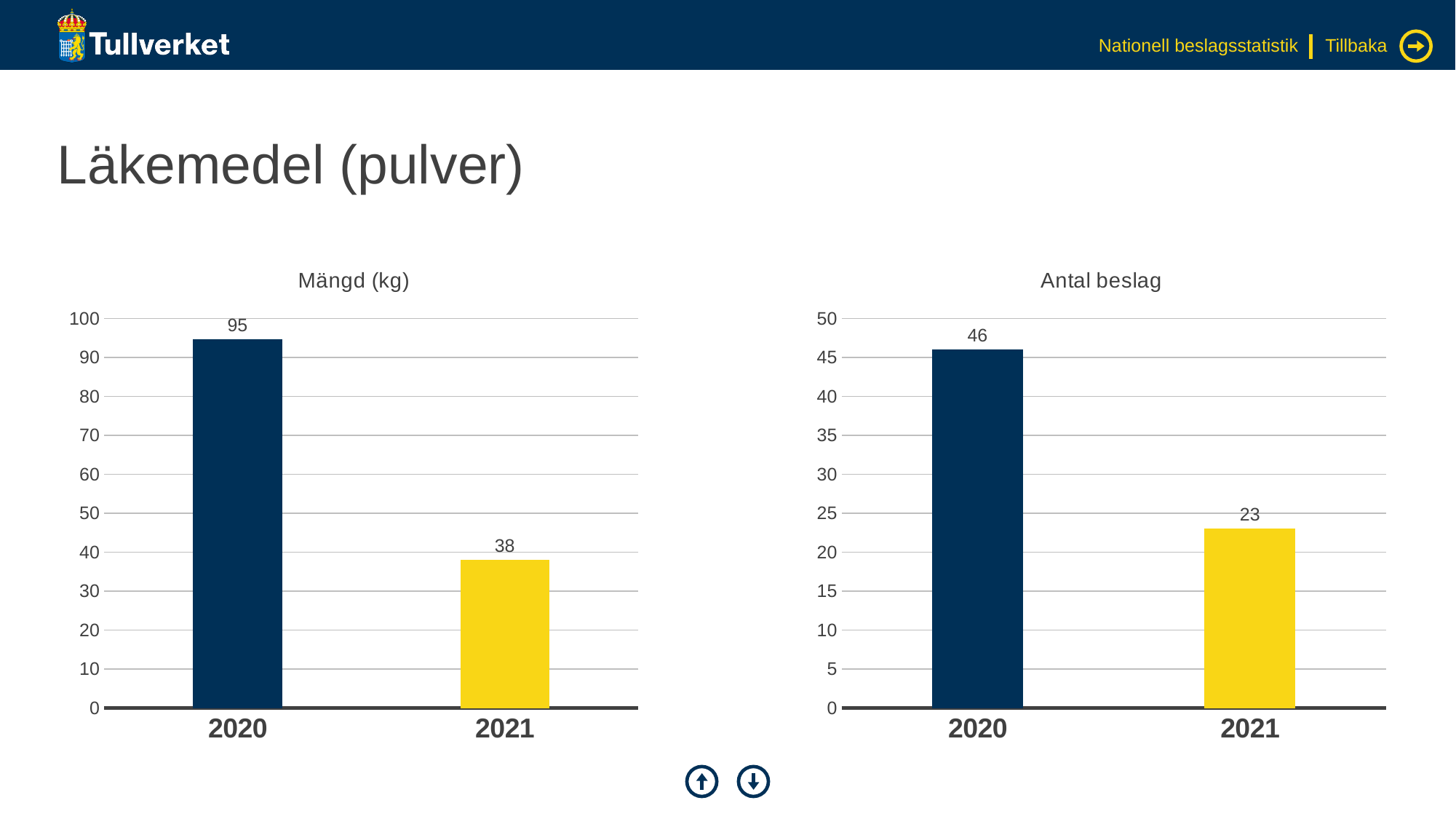
In the 'Mängd (kg)' chart, what is the value for 2020? 95 In the 'Antal beslag' chart, which year has the lowest value? 2021 In the 'Mängd (kg)' chart, which year has the highest value? 2020 In the 'Antal beslag' chart, what is the value for 2020? 46 In the 'Mängd (kg)' chart, do the values rise or fall from 2020 to 2021? Fall What kind of chart is the 'Antal beslag' chart? Bar chart How many categories are shown on the x axis of the 'Mängd (kg)' chart? 2 In the 'Mängd (kg)' chart, what is the difference between the 2020 and 2021 values? 57 In the 'Antal beslag' chart, what is the difference between the 2020 and 2021 values? 23 In the 'Mängd (kg)' chart, what is the value for 2021? 38 In the 'Antal beslag' chart, what is the value for 2021? 23 In the 'Antal beslag' chart, is the value for 2020 greater or less than 40? greater